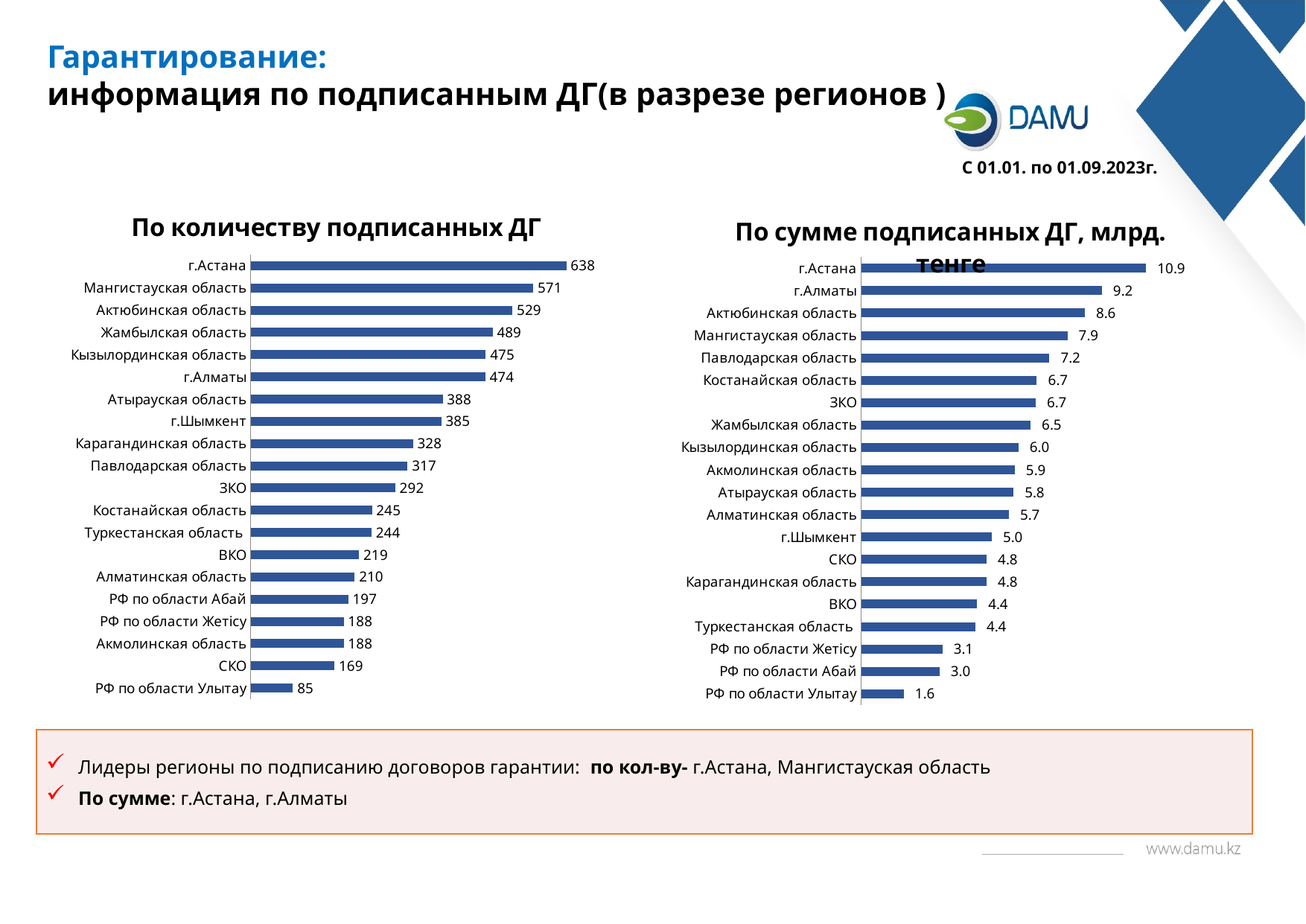
In the chart 'По сумме подписанных ДГ, млрд. тенге', which is larger: Актюбинская область or Мангистауская область? Актюбинская область What type of chart is 'По сумме подписанных ДГ, млрд. тенге'? Bar chart In the chart 'По количеству подписанных ДГ', which category has the lowest value? РФ по области Улытау How many categories are shown in the chart 'По количеству подписанных ДГ'? 20 In the chart 'По сумме подписанных ДГ, млрд. тенге', which category has the highest value? г.Астана In the chart 'По сумме подписанных ДГ, млрд. тенге', what is the value for Павлодарская область? 7.2 In the chart 'По количеству подписанных ДГ', which is larger: Атырауская область or г.Шымкент? Атырауская область In the chart 'По количеству подписанных ДГ', what is the value for г.Астана? 638 In the chart 'По количеству подписанных ДГ', what is the value for Карагандинская область? 328 In the chart 'По сумме подписанных ДГ, млрд. тенге', what is the value for г.Алматы? 9.2 In the chart 'По сумме подписанных ДГ, млрд. тенге', what is the difference between г.Астана and РФ по области Улытау? 9.3 In the chart 'По количеству подписанных ДГ', what is the difference between г.Астана and Мангистауская область? 67